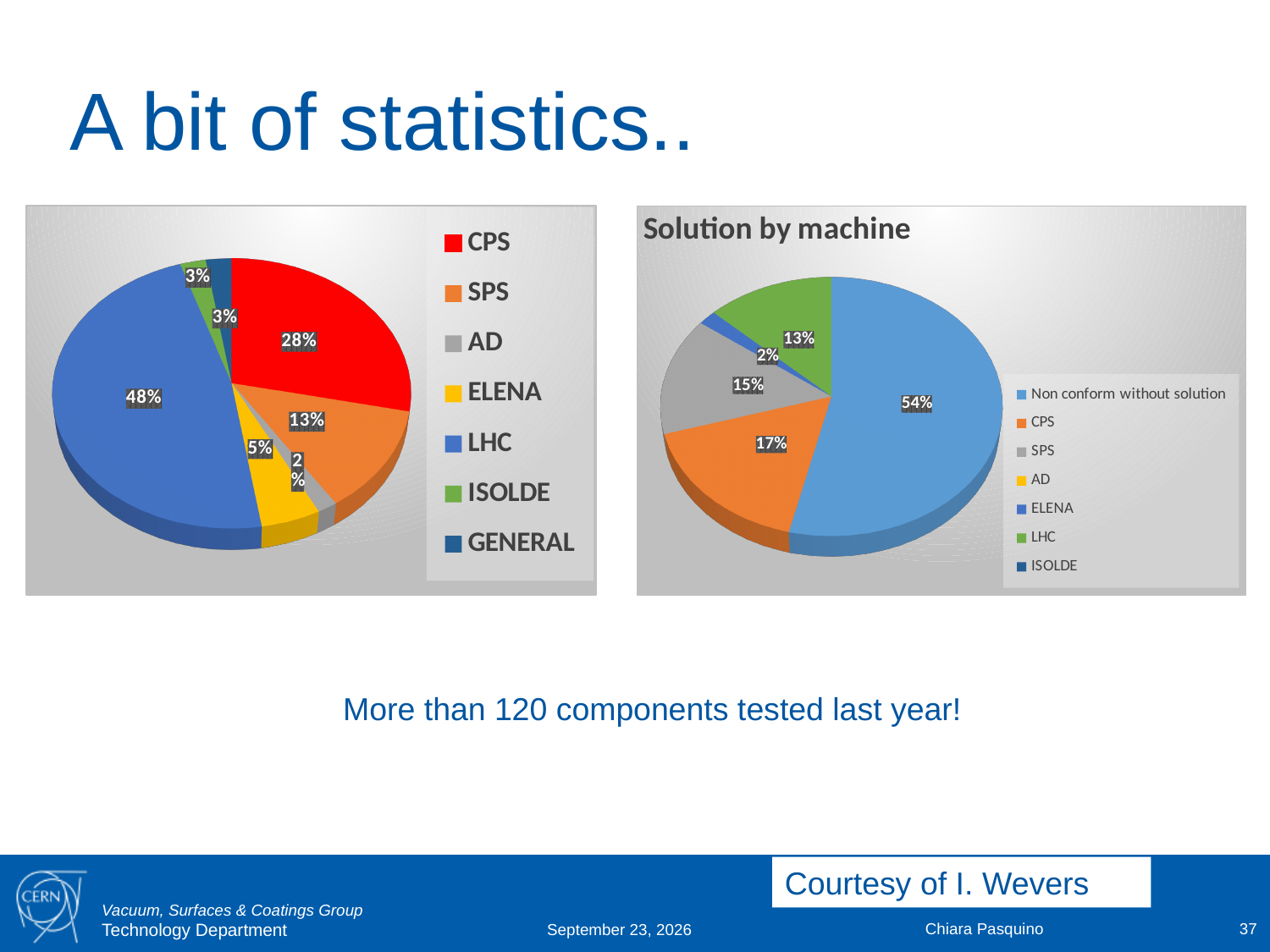
On the left pie chart, how many categories does the legend list? 7 On the left pie chart, what share does SPS have? 13% On the left pie chart, what share does LHC have? 48% On the 'Solution by machine' chart, what share is labelled 'Non conform without solution'? 54% On the 'Solution by machine' chart, what share does LHC have? 13% On the 'Solution by machine' chart, which is larger, the SPS share or the LHC share? SPS On the 'Solution by machine' chart, what share does CPS have? 17% On the left pie chart, which category has the largest slice? LHC On the left pie chart, what share does CPS have? 28% On the left pie chart, what is the difference between the LHC share and the CPS share? 20% What kind of chart is the 'Solution by machine' chart? Pie chart On the 'Solution by machine' chart, how many entries does the legend list? 7